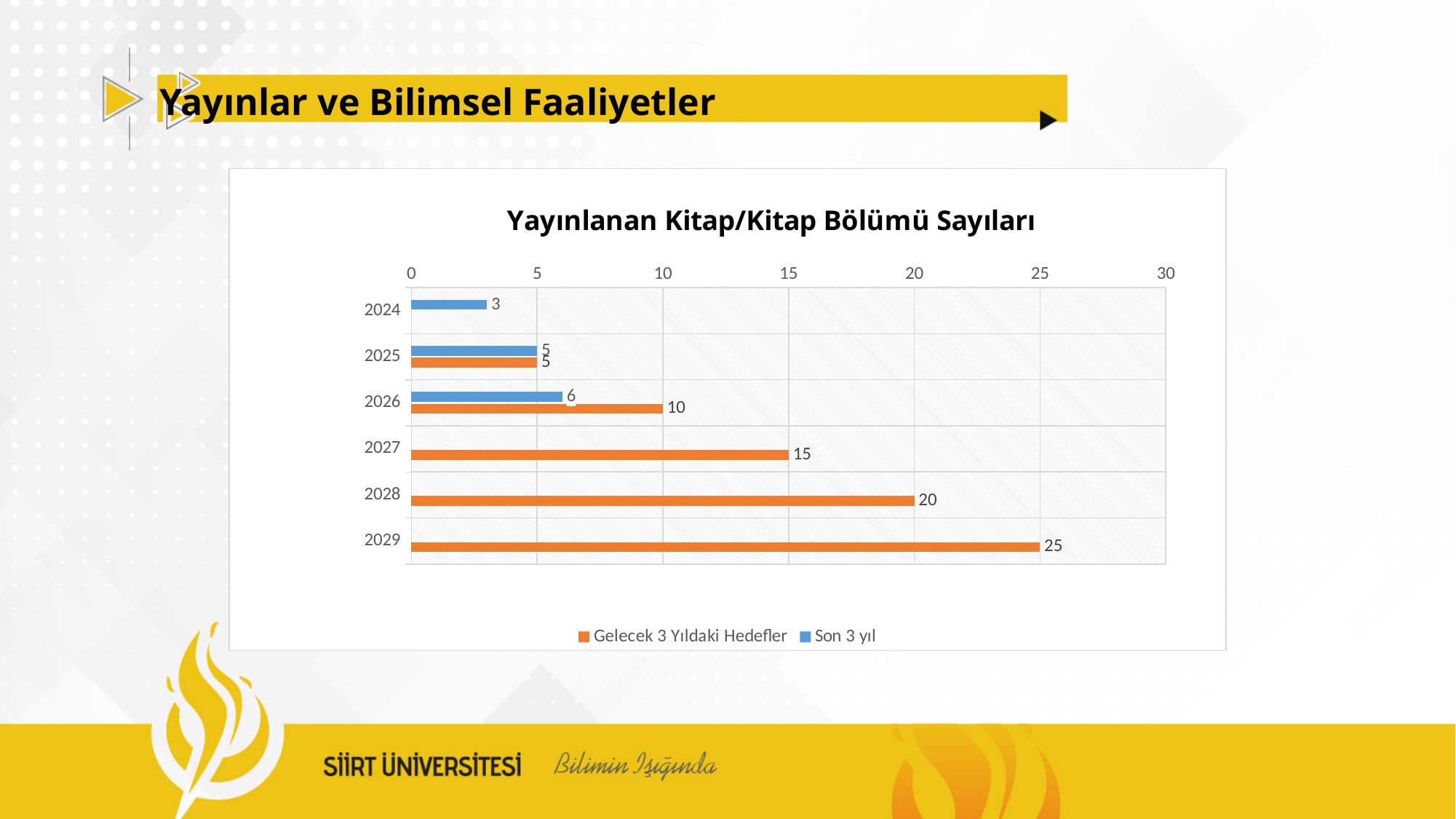
What kind of chart is shown on the slide? bar chart How many years are shown on the vertical axis of the chart? 6 What is the value of "Son 3 yıl" for 2026? 6 Which year has the lowest value for "Son 3 yıl"? 2024 Which year has the highest value for "Gelecek 3 Yıldaki Hedefler"? 2029 What is the value of "Gelecek 3 Yıldaki Hedefler" for 2027? 15 Is the value of "Gelecek 3 Yıldaki Hedefler" for 2028 greater or less than 15? greater How many series does the legend list? 2 Which is larger for 2026: "Son 3 yıl" or "Gelecek 3 Yıldaki Hedefler"? Gelecek 3 Yıldaki Hedefler What is the value of "Son 3 yıl" for 2024? 3 What is the title of the chart? Yayınlanan Kitap/Kitap Bölümü Sayıları What is the difference between the "Gelecek 3 Yıldaki Hedefler" values for 2029 and 2028? 5